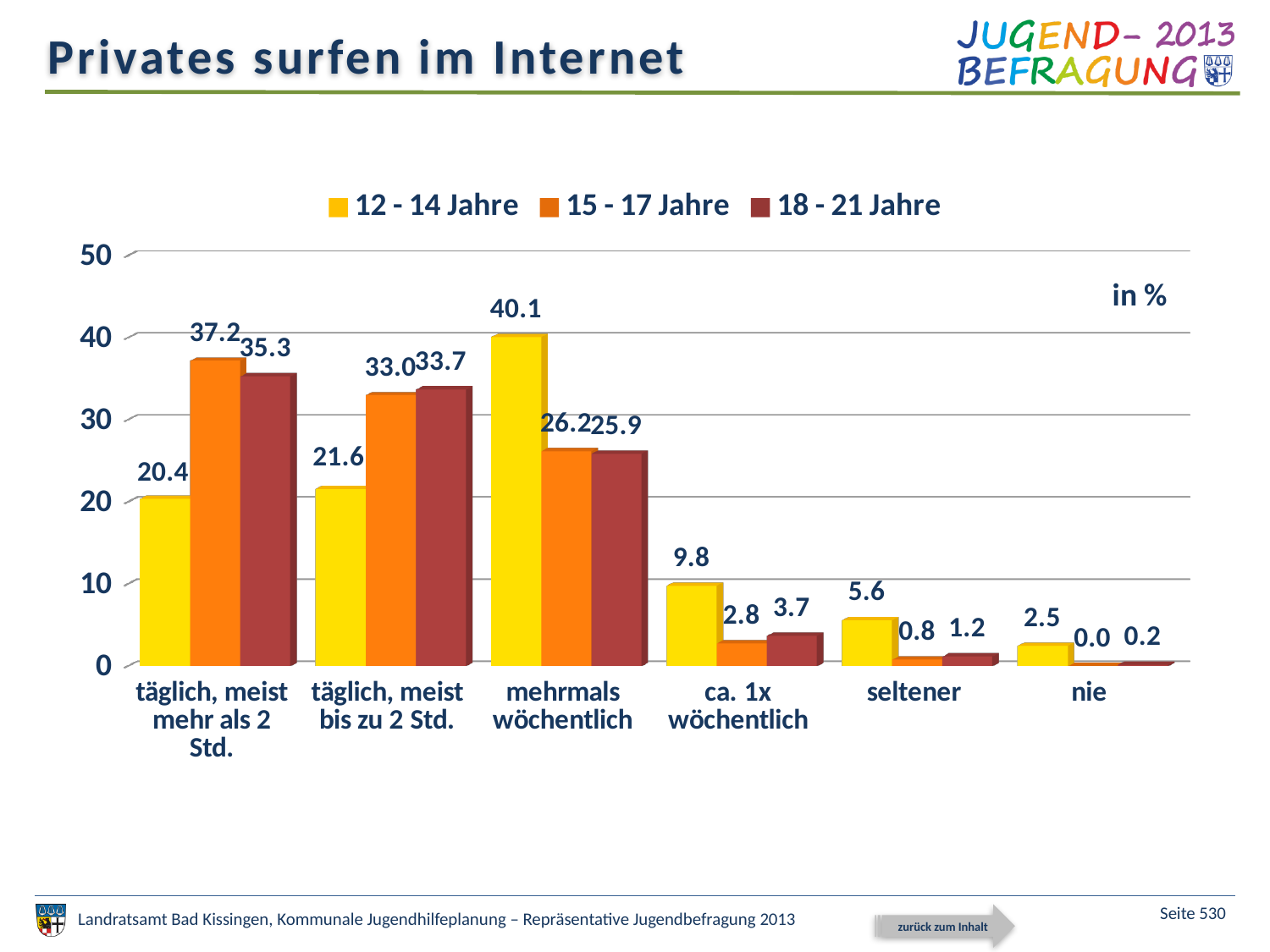
What is the difference between the 15 - 17 Jahre and 12 - 14 Jahre values in the 'täglich, meist mehr als 2 Std.' category? 16.8 Is the value for 18 - 21 Jahre in the 'täglich, meist bis zu 2 Std.' category greater or less than 30? greater What unit is indicated for the values in the chart? in % How many categories are shown on the x axis? 6 What kind of chart is shown on the slide? bar chart What is the value for 15 - 17 Jahre in the 'täglich, meist mehr als 2 Std.' category? 37.2 Which category has the highest value for the 12 - 14 Jahre series? mehrmals wöchentlich In the 'ca. 1x wöchentlich' category, which series has the larger value: 12 - 14 Jahre or 18 - 21 Jahre? 12 - 14 Jahre Which category has the lowest value for the 15 - 17 Jahre series? nie What is the value for 12 - 14 Jahre in the 'mehrmals wöchentlich' category? 40.1 What is the value for 18 - 21 Jahre in the 'nie' category? 0.2 How many series does the legend list? 3